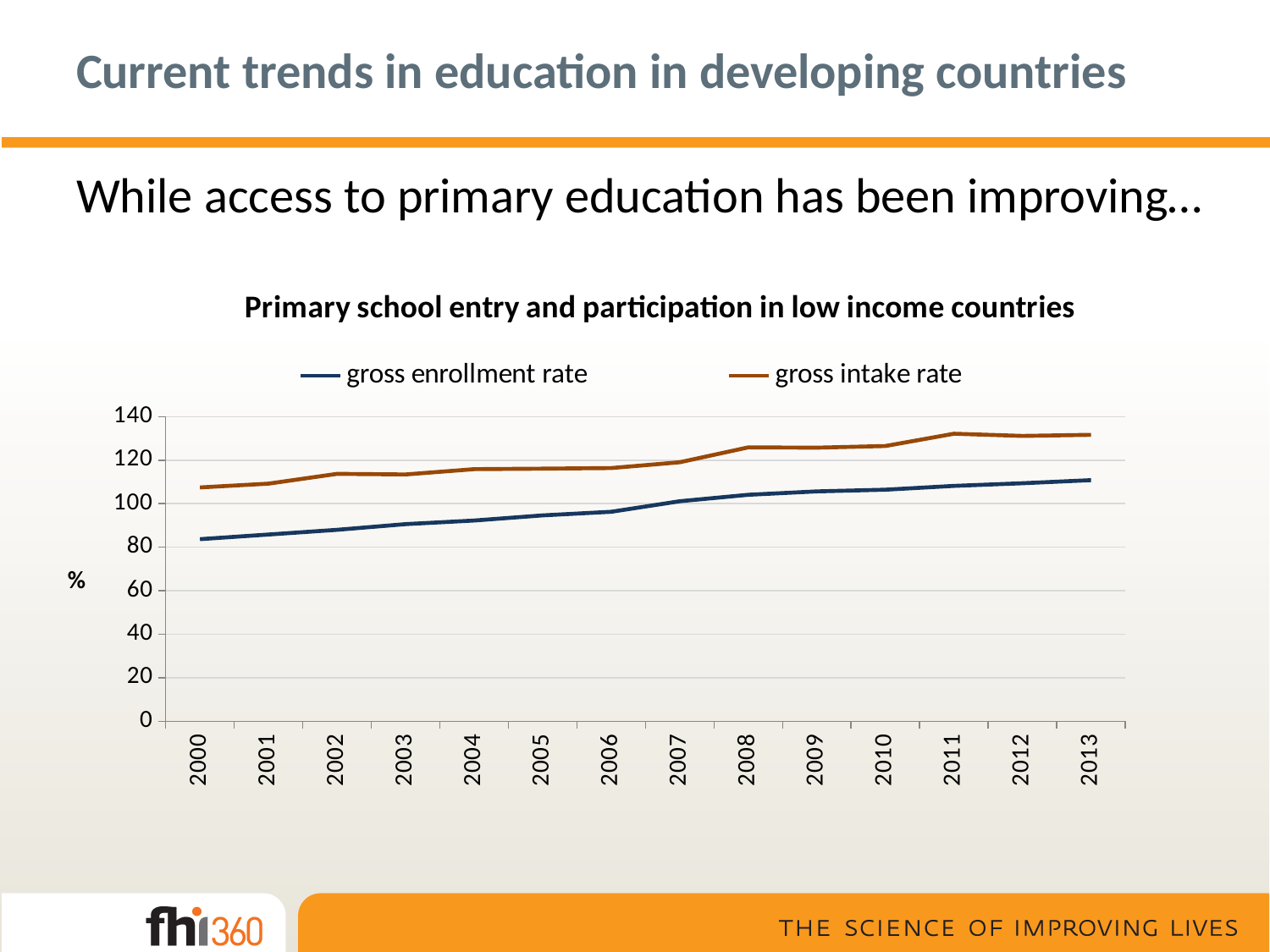
Is the gross enrollment rate in 2000 greater or less than 100? less Does the gross enrollment rate rise or fall from 2000 to 2013? rise What is the title of the chart? Primary school entry and participation in low income countries Is the gross enrollment rate in 2013 greater or less than 100? greater What label is shown on the vertical axis? % In which year is the gross enrollment rate lowest? 2000 In 2005, which series has the higher value, gross enrollment rate or gross intake rate? gross intake rate What kind of chart is shown on the slide? line chart Is the gross intake rate in 2013 greater or less than 120? greater How many years are plotted along the x axis? 14 Does the gross intake rate rise or fall from 2000 to 2013? rise How many series does the legend list? 2